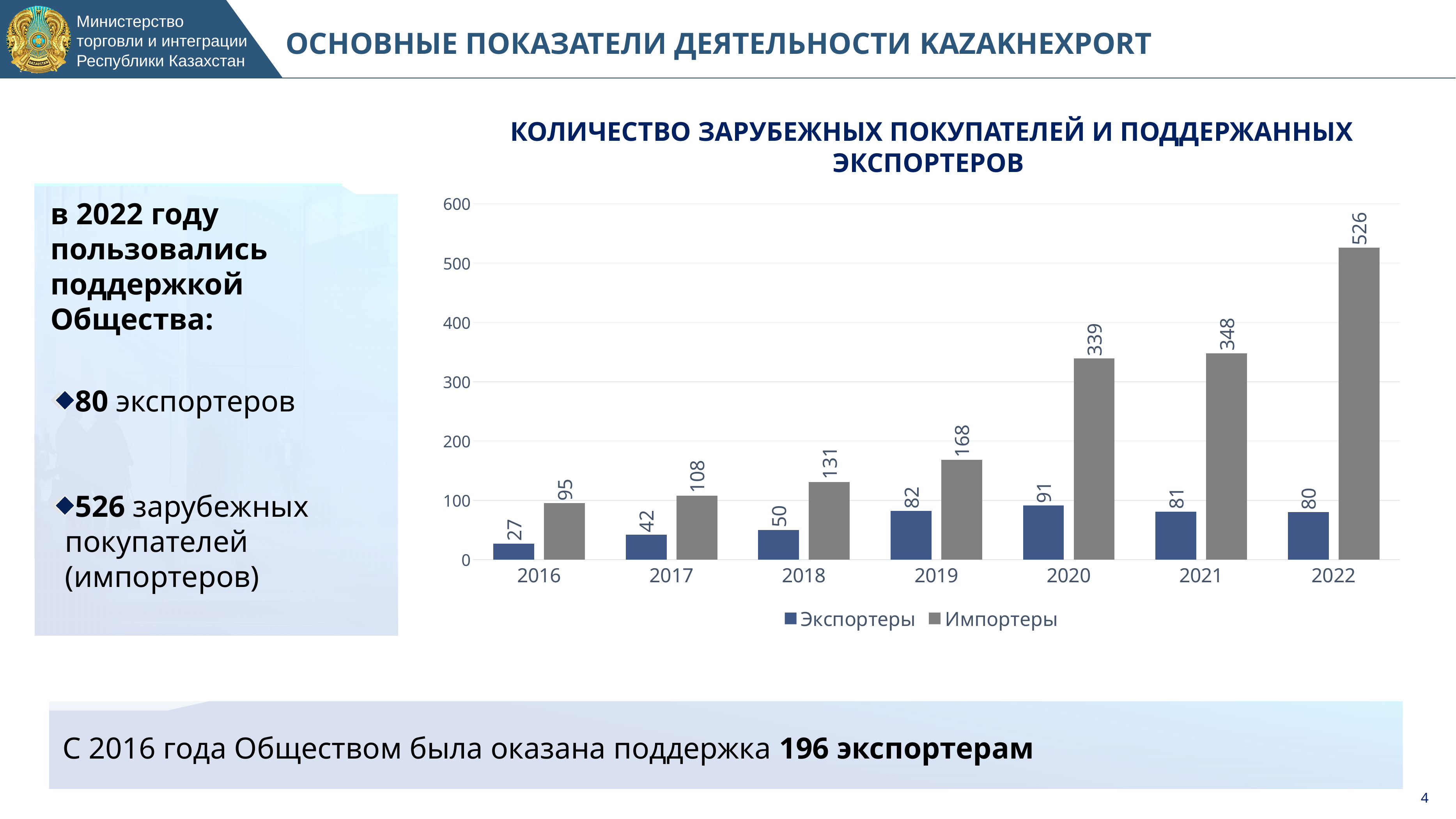
How many years are shown on the x axis? 7 Do the values for Импортеры rise or fall from 2016 to 2022? Rise What is the difference between Импортеры and Экспортеры in 2022? 446 What is the value for Импортеры in 2021? 348 Which is larger: Экспортеры in 2020 or Экспортеры in 2021? Экспортеры in 2020 What kind of chart is shown on the slide? Bar chart How many series does the legend list? 2 What colour are the bars for Экспортеры? Blue Which year has the lowest value for Экспортеры? 2016 What is the value for Экспортеры in 2019? 82 Which year has the highest value for Импортеры? 2022 Is the value for Импортеры in 2020 greater or less than 300? greater